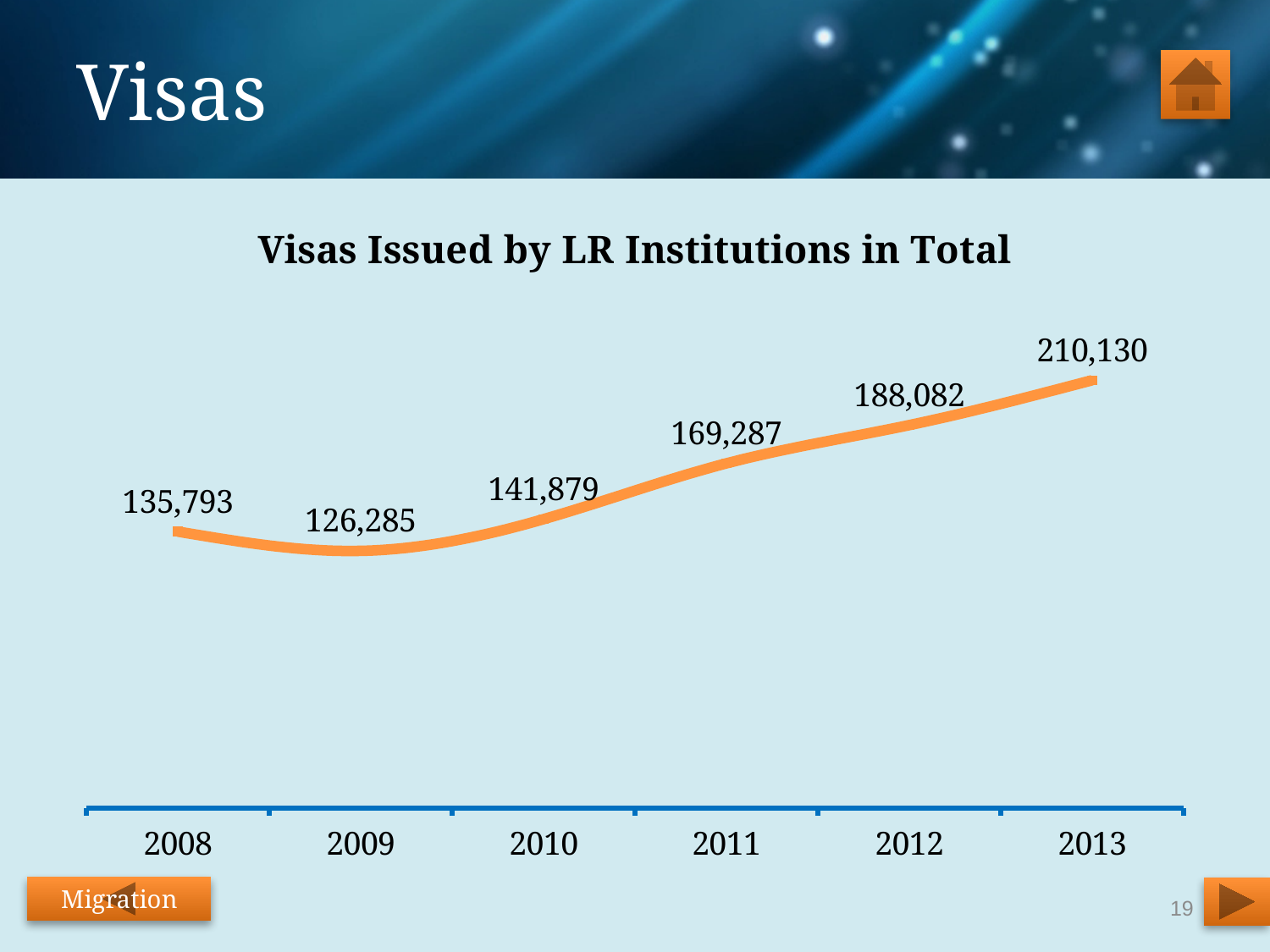
What is the title of the chart? Visas Issued by LR Institutions in Total What is the value for 2011 in the Visas Issued by LR Institutions in Total chart? 169,287 What kind of chart is shown on the slide? line chart Which is larger, the value for 2010 or the value for 2011? 2011 What is the value for 2008 in the Visas Issued by LR Institutions in Total chart? 135,793 How many years are plotted on the chart? 6 What is the difference between the values for 2013 and 2012? 22,048 What is the value for 2013 in the Visas Issued by LR Institutions in Total chart? 210,130 Which year has the lowest number of visas issued? 2009 What is the difference between the values for 2008 and 2009? 9,508 Do the values rise or fall from 2009 to 2013? rise Which year has the highest number of visas issued? 2013